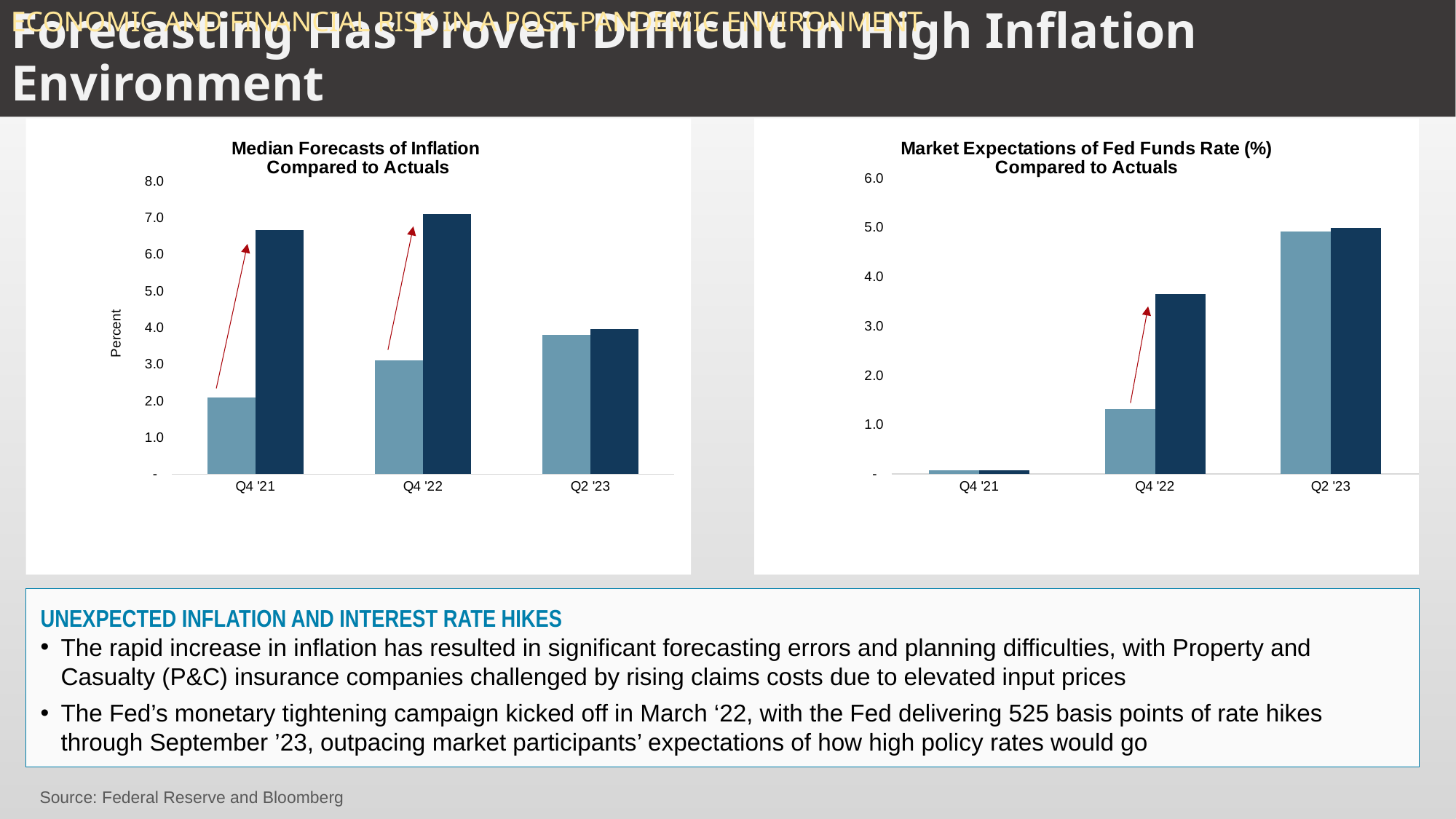
In the left chart, 'Median Forecasts of Inflation Compared to Actuals', for Q4 '21, which bar is larger: the light blue bar or the dark blue bar? The dark blue bar In the left chart, 'Median Forecasts of Inflation Compared to Actuals', is the light blue bar for Q4 '21 greater or less than 3.0? less In the right chart, 'Market Expectations of Fed Funds Rate (%) Compared to Actuals', do the light blue bars rise or fall from Q4 '21 to Q2 '23? Rise What is the y-axis label of the left chart, 'Median Forecasts of Inflation Compared to Actuals'? Percent What is the title of the left chart? Median Forecasts of Inflation Compared to Actuals In the left chart, 'Median Forecasts of Inflation Compared to Actuals', which category has the tallest dark blue bar? Q4 '22 In the right chart, 'Market Expectations of Fed Funds Rate (%) Compared to Actuals', which category has the lowest bars? Q4 '21 In the right chart, 'Market Expectations of Fed Funds Rate (%) Compared to Actuals', is the dark blue bar for Q4 '22 greater or less than 3.0? greater How many categories are shown on the x axis of the right chart, 'Market Expectations of Fed Funds Rate (%) Compared to Actuals'? 3 In the right chart, 'Market Expectations of Fed Funds Rate (%) Compared to Actuals', is the light blue bar for Q4 '22 greater or less than 2.0? less What kind of chart is the left chart, 'Median Forecasts of Inflation Compared to Actuals'? Bar chart